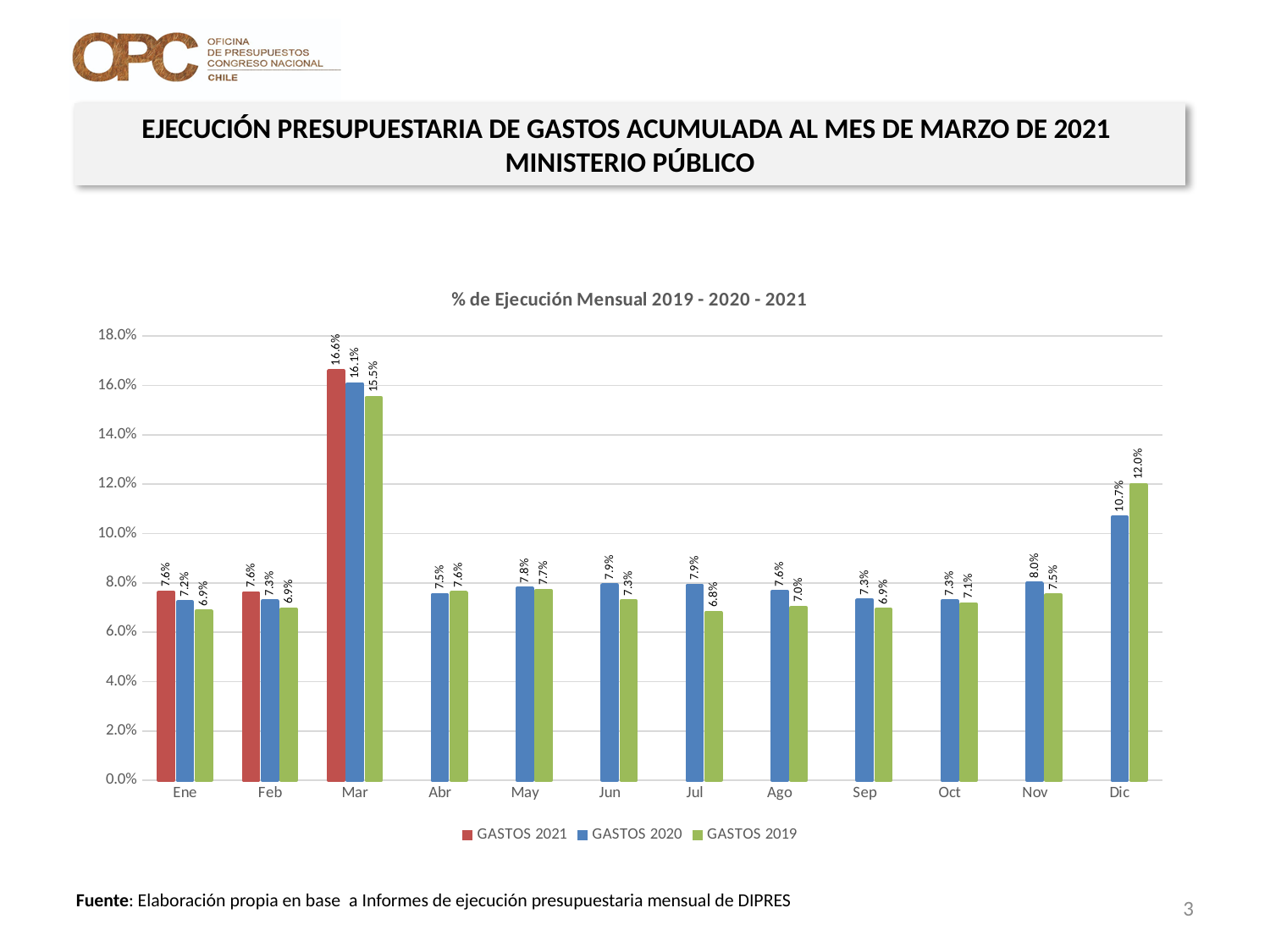
What is the value for GASTOS 2019 in Dic? 12.0% In which month is the GASTOS 2019 value lowest? Jul How many series does the legend list? 3 What is the difference between GASTOS 2021 and GASTOS 2019 in Mar? 1.1% What is the value for GASTOS 2021 in Mar? 16.6% In which month is the GASTOS 2020 value highest? Mar Which is larger in Dic, GASTOS 2020 or GASTOS 2019? GASTOS 2019 What is the title of the chart? % de Ejecución Mensual 2019 - 2020 - 2021 How many categories are shown on the x axis? 12 What type of chart is shown on the slide? bar chart What is the value for GASTOS 2020 in Nov? 8.0% How many months have a GASTOS 2021 bar? 3